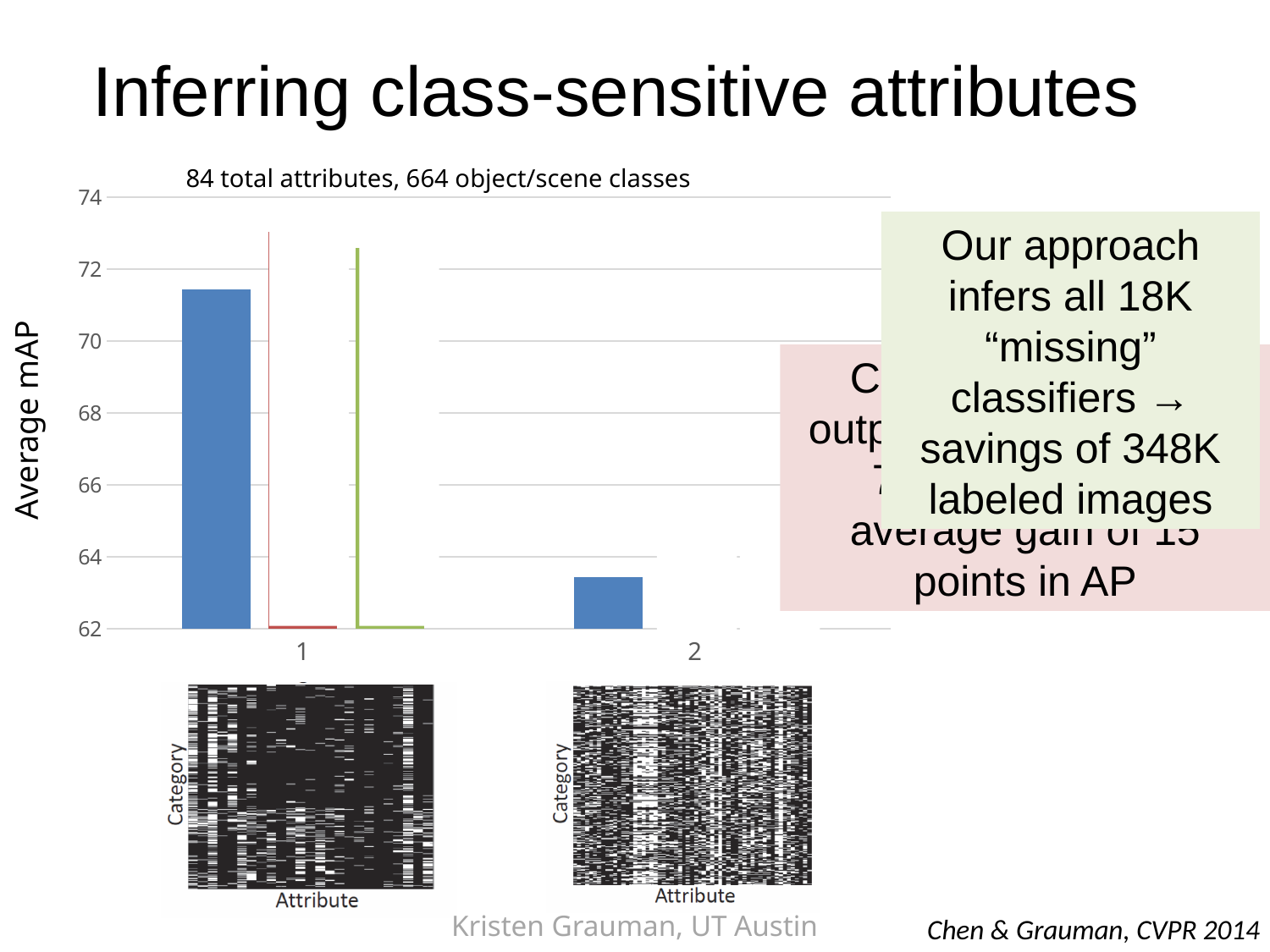
What kind of chart is shown on the slide? bar chart What is the label on the y axis of the chart? Average mAP For category 1, which bar is taller, the blue bar or the red bar? blue What is the title of the chart? 84 total attributes, 664 object/scene classes Is the value of the blue bar for category 1 greater or less than 70? greater Is the value of the blue bar for category 2 greater or less than 64? less Is the value of the blue bar for category 1 greater or less than 72? less Do the blue bars rise or fall from category 1 to category 2? fall How many categories are shown on the x axis of the chart? 2 Which category has the higher blue bar, 1 or 2? 1